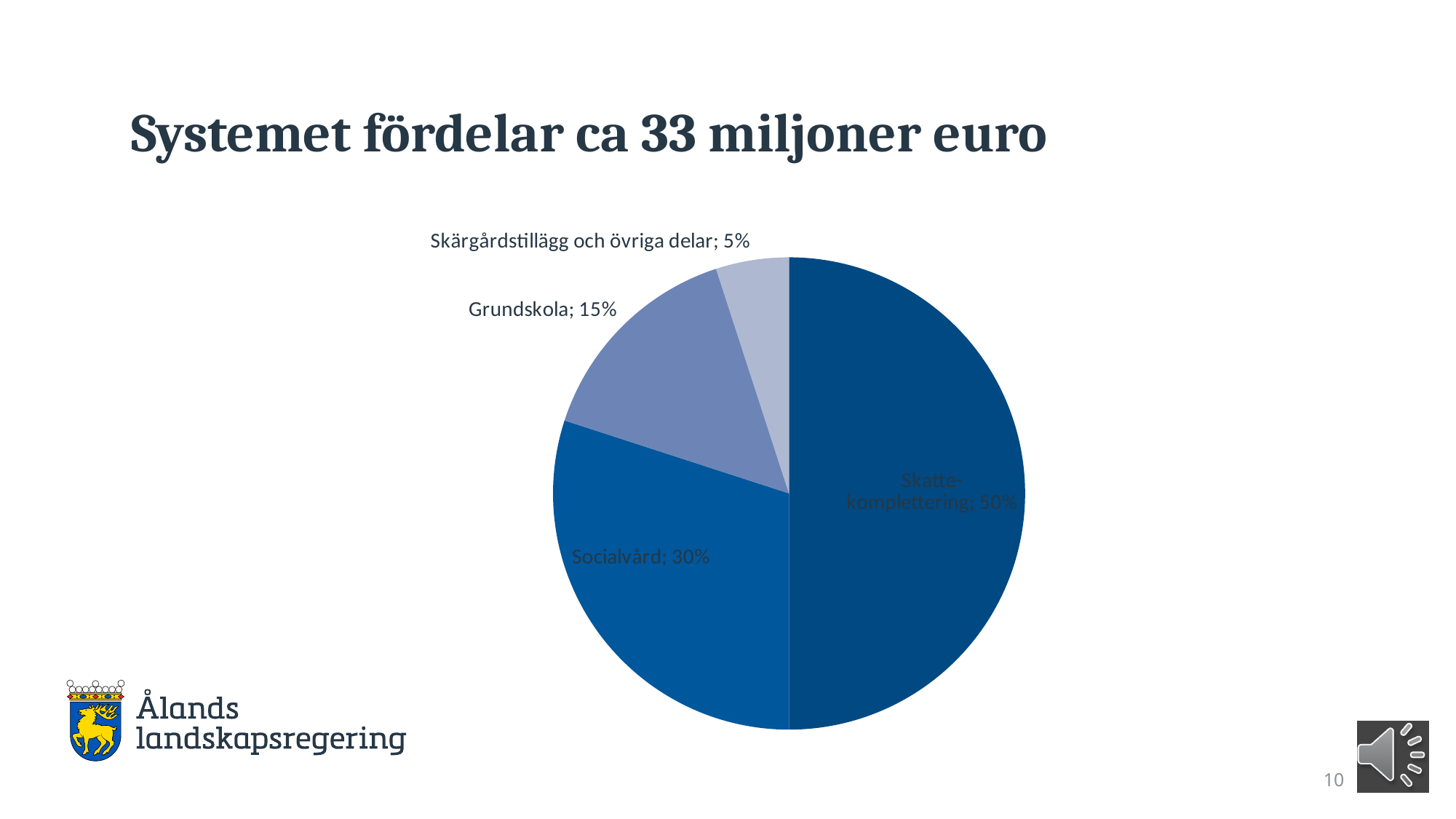
Which category has the smallest slice of the pie? Skärgårdstillägg och övriga delar What is the difference in percentage points between Socialvård and Grundskola? 15% What is the difference in percentage points between Skattekomplettering and Skärgårdstillägg och övriga delar? 45% What share of the pie does Grundskola have? 15% What kind of chart is shown on the slide? pie chart What is the title of the slide containing the pie chart? Systemet fördelar ca 33 miljoner euro Which is larger, the share for Grundskola or the share for Socialvård? Socialvård What share of the pie does Socialvård have? 30% What share of the pie does Skärgårdstillägg och övriga delar have? 5% How many slices does the pie chart have? 4 Which category has the largest slice of the pie? Skattekomplettering